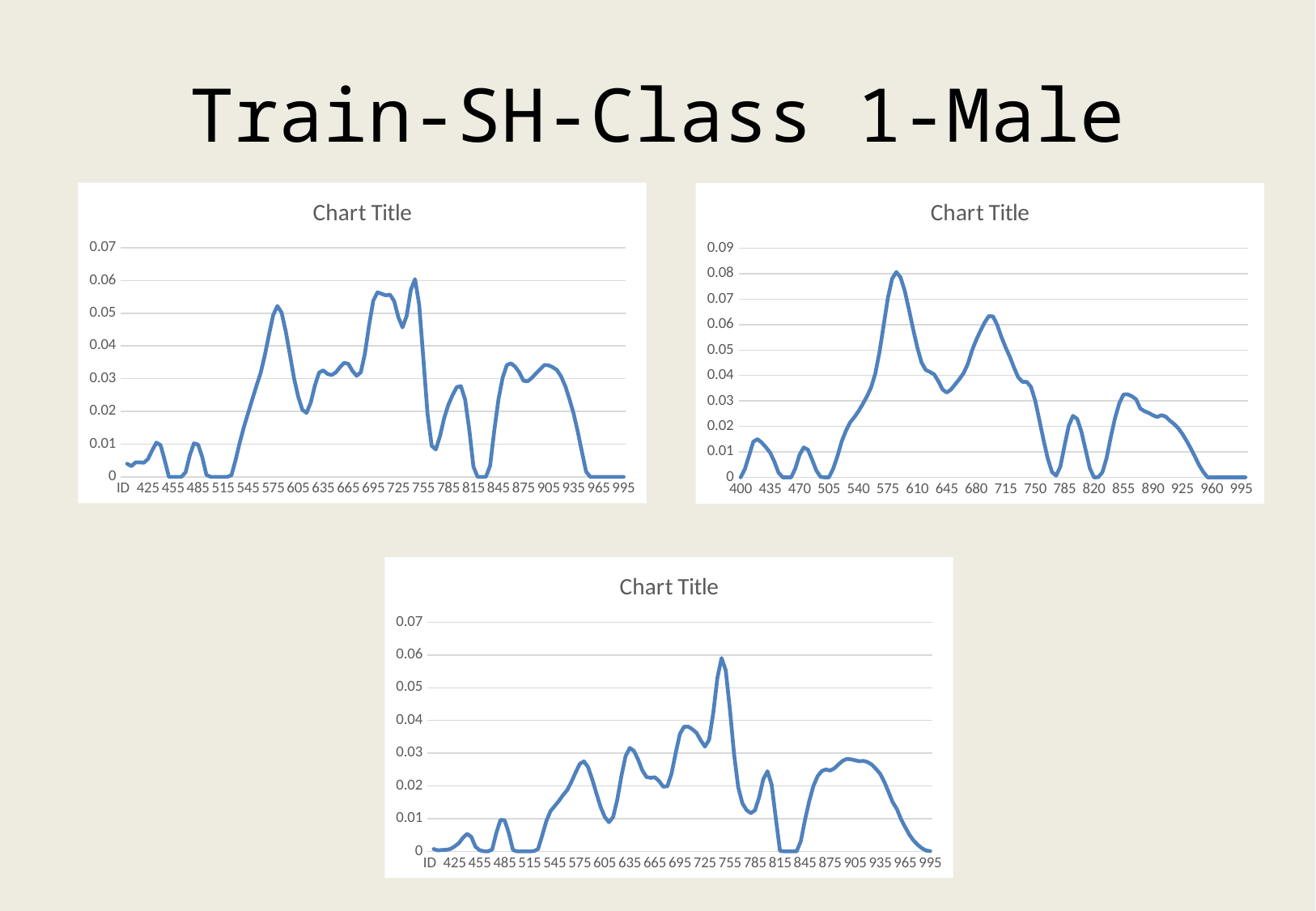
What is the title printed on the top-right chart? Chart Title In the top-right chart, does the line rise or fall between 505 and 575? rise How many charts are shown on the slide? 3 In the top-right chart, is the value at 995 greater or less than 0.01? less In the bottom chart, is the value at 815 greater or less than 0.01? less In the top-left chart, is the value at 455 greater or less than 0.01? less What kind of chart is the top-left chart? line chart What is the highest tick value on the y axis of the top-right chart? 0.09 In the bottom chart, does the line rise or fall between 935 and 995? fall